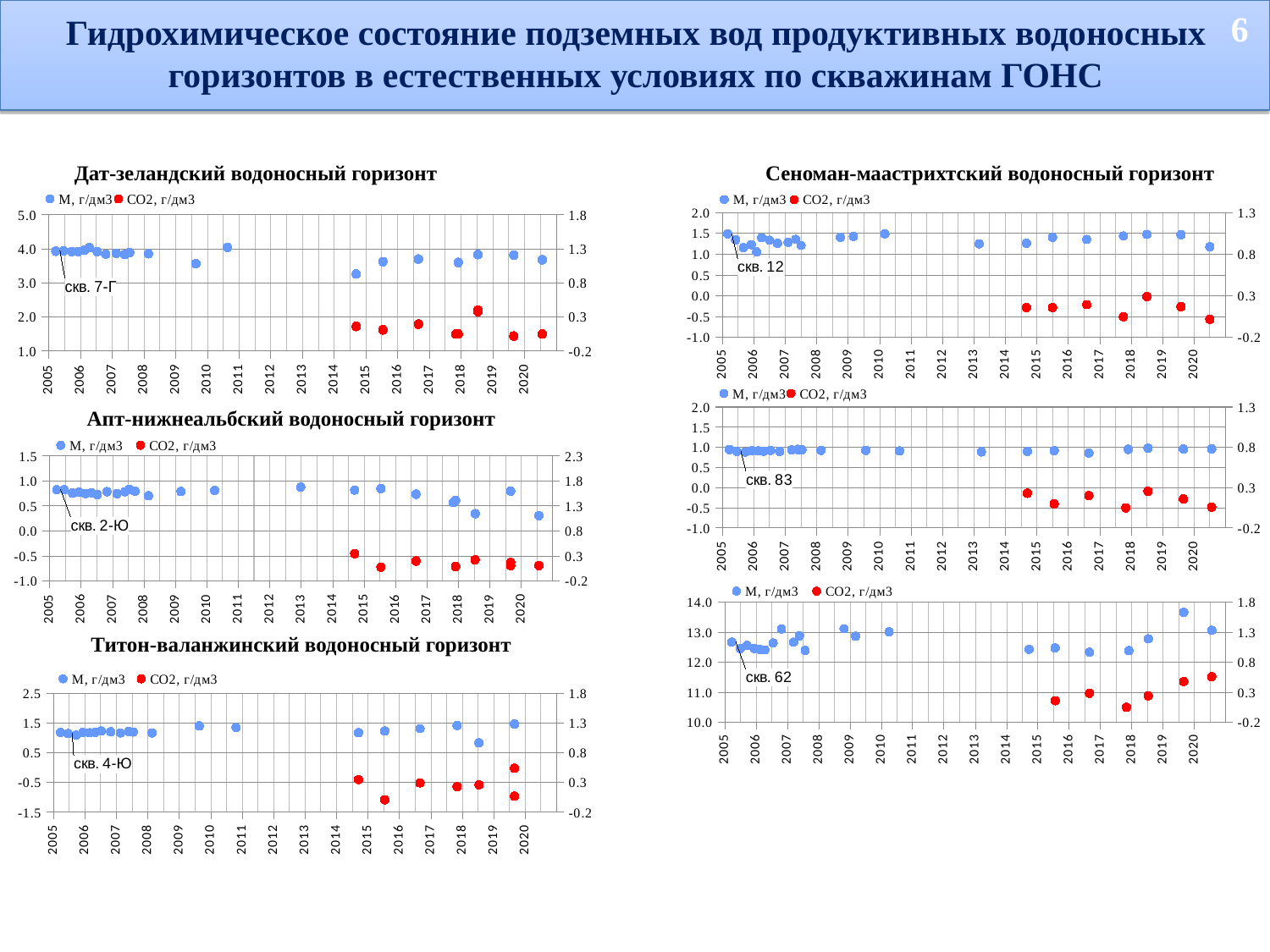
What kind of chart is the 'Дат-зеландский водоносный горизонт' chart? scatter chart Which well number is annotated on the 'Титон-валанжинский водоносный горизонт' chart? скв. 4-Ю How many series does the legend of the 'Апт-нижнеальбский водоносный горизонт' chart list? 2 In the bottom 'Сеноман-маастрихтский водоносный горизонт' chart (скв. 62), is the value of М, г/дм3 in 2005 greater or less than 12.0? greater In the 'Апт-нижнеальбский водоносный горизонт' chart, is the value of М, г/дм3 in 2013 greater or less than 0.5? greater In the 'Апт-нижнеальбский водоносный горизонт' chart, does the М, г/дм3 series rise or fall from 2017 to 2019? rise In the 'Дат-зеландский водоносный горизонт' chart, is the value of М, г/дм3 in 2005 greater or less than 3.0? greater In the bottom 'Сеноман-маастрихтский водоносный горизонт' chart (скв. 62), does the М, г/дм3 series rise or fall from 2018 to 2020? rise What are the two legend entries on the 'Титон-валанжинский водоносный горизонт' chart? М, г/дм3 and CO2, г/дм3